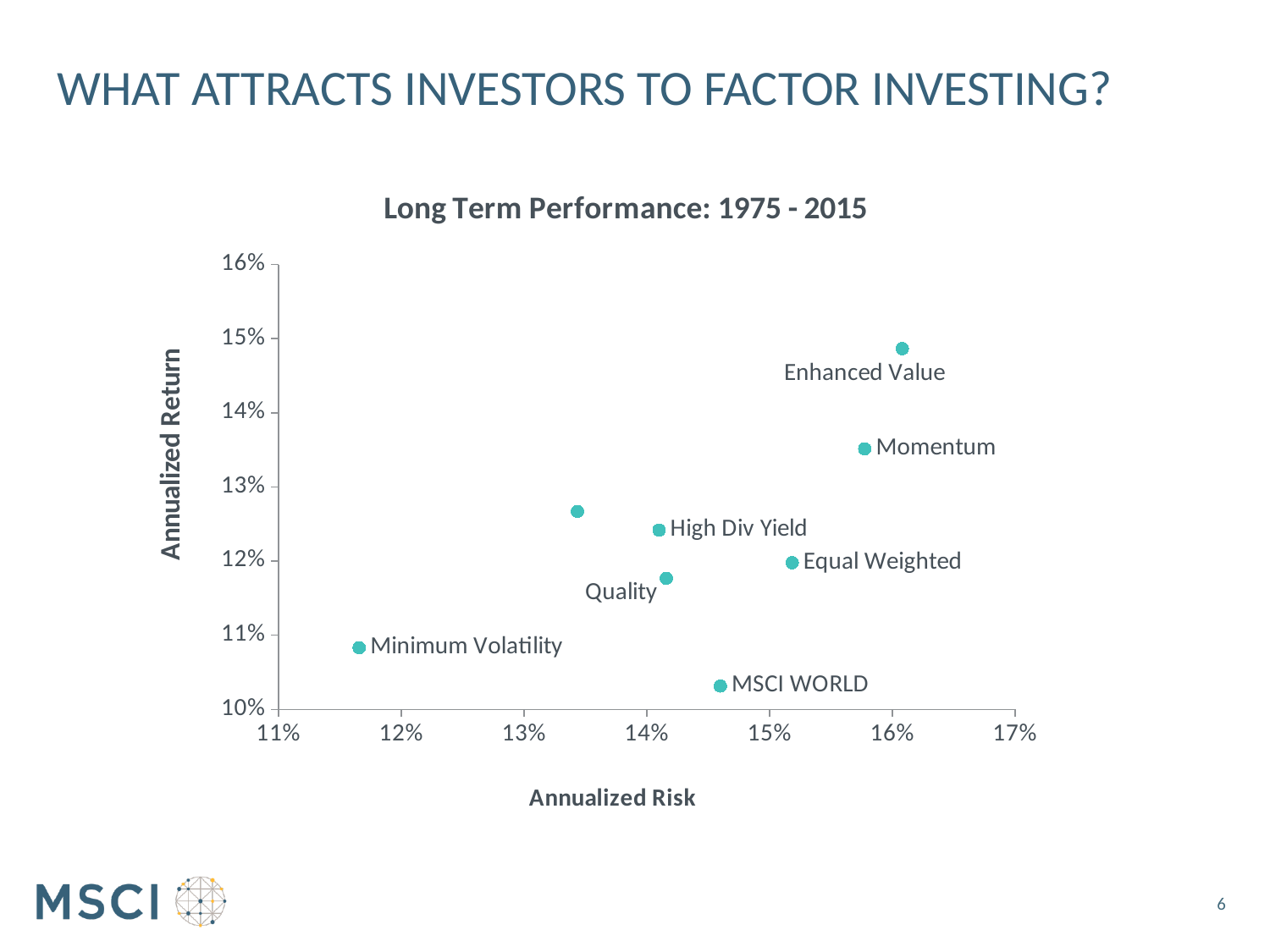
Is the annualized return for MSCI WORLD greater or less than 11%? less Which labeled point has the lowest annualized risk? Minimum Volatility What is the label of the horizontal axis? Annualized Risk What kind of chart is shown on the slide? Scatter chart How many data points are plotted on the chart? 8 Is the annualized risk for Minimum Volatility greater or less than 12%? less Which labeled point has the lowest annualized return? MSCI WORLD Which labeled point has the highest annualized return? Enhanced Value Which has the higher annualized return, Momentum or High Div Yield? Momentum Is the annualized return for Enhanced Value greater or less than 14%? greater What is the title of the chart? Long Term Performance: 1975 - 2015